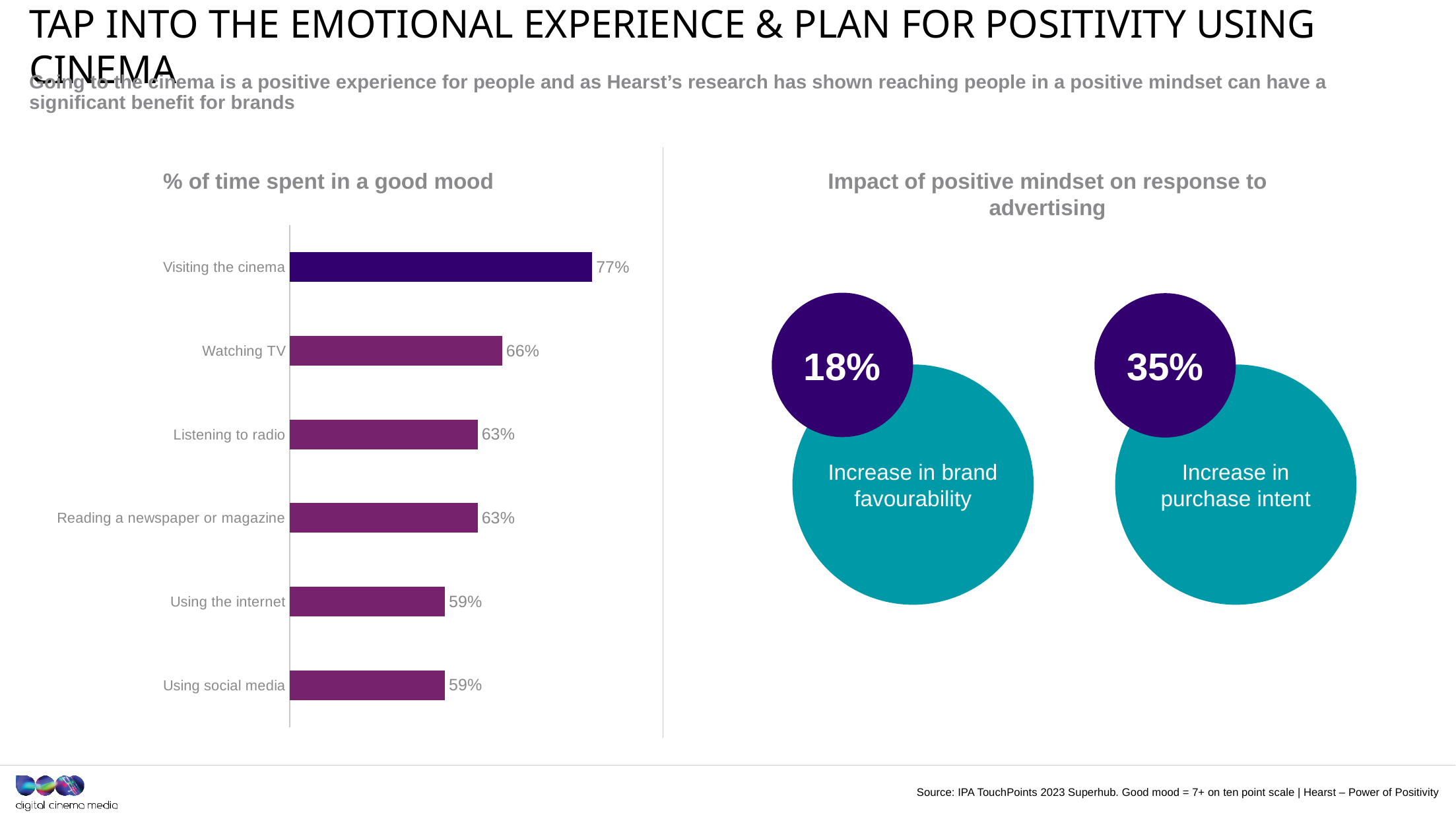
In the '% of time spent in a good mood' chart, what is the value for Listening to radio? 63% In the '% of time spent in a good mood' chart, what is the value for Using the internet? 59% How many activities are shown in the '% of time spent in a good mood' chart? 6 In the '% of time spent in a good mood' chart, which is larger: Watching TV or Using social media? Watching TV In the 'Impact of positive mindset on response to advertising' graphic, what is the increase in brand favourability? 18% In the 'Impact of positive mindset on response to advertising' graphic, what is the increase in purchase intent? 35% In the '% of time spent in a good mood' chart, what is the value for Visiting the cinema? 77% In the '% of time spent in a good mood' chart, which activity has the highest value? Visiting the cinema What kind of chart is the '% of time spent in a good mood' chart? Bar chart In the '% of time spent in a good mood' chart, what is the difference between Visiting the cinema and Watching TV? 11 percentage points In the '% of time spent in a good mood' chart, which bar is shown in a darker colour than the others? Visiting the cinema In the '% of time spent in a good mood' chart, what is the value for Watching TV? 66%